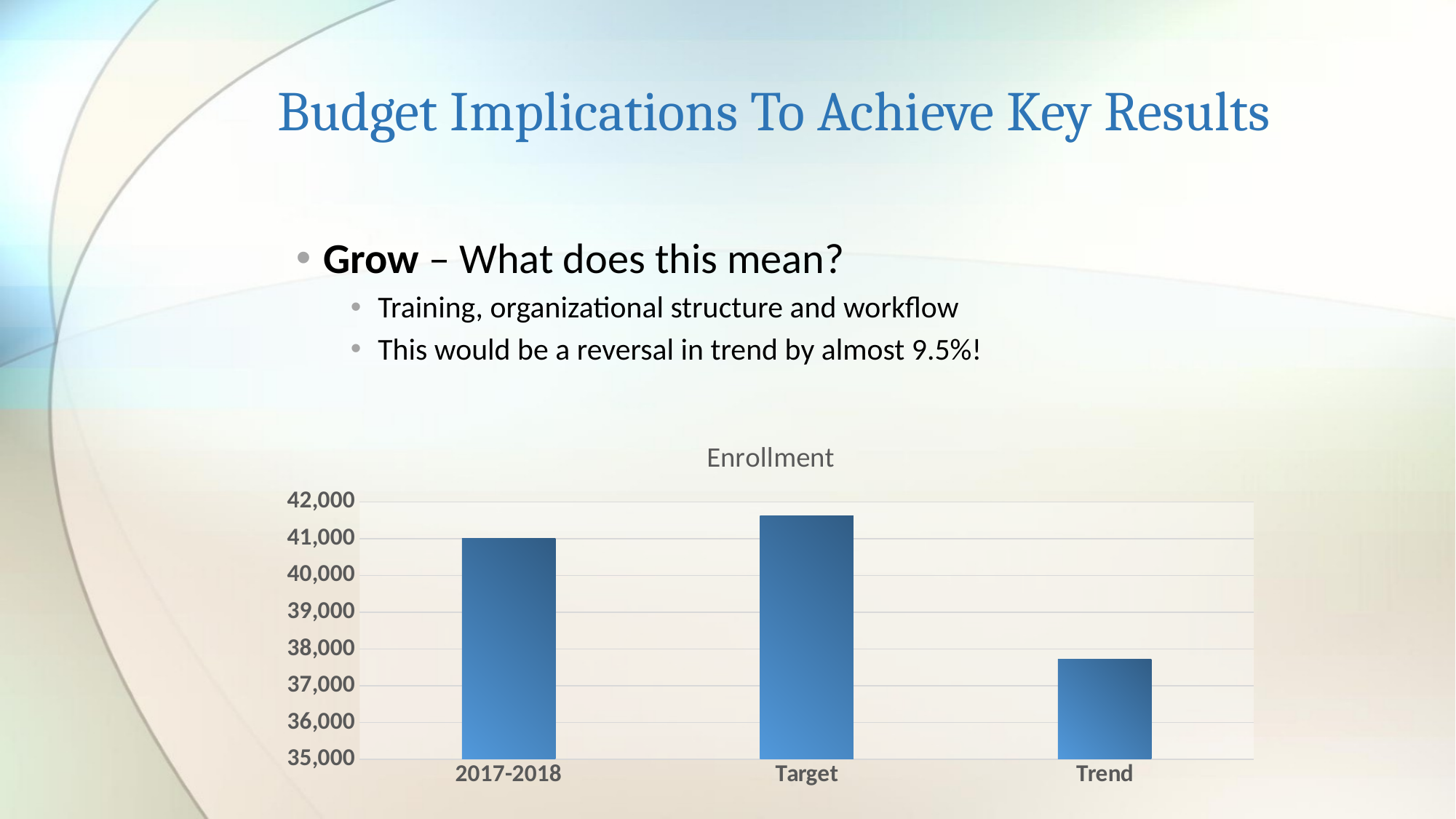
Which is larger, the value for 2017-2018 or the value for Trend? 2017-2018 What is the title of the chart? Enrollment What kind of chart is shown on the slide? bar chart Is the value for Trend greater or less than 37,000? greater What is the value for 2017-2018 in the Enrollment chart? 41,000 How many categories are shown on the x axis of the Enrollment chart? 3 Which category has the lowest value in the Enrollment chart? Trend Is the value for Trend greater or less than 38,000? less What is the lowest value shown on the y axis of the Enrollment chart? 35,000 Is the value for Target greater or less than 41,000? greater Which is larger, the value for Target or the value for 2017-2018? Target Which category has the highest value in the Enrollment chart? Target